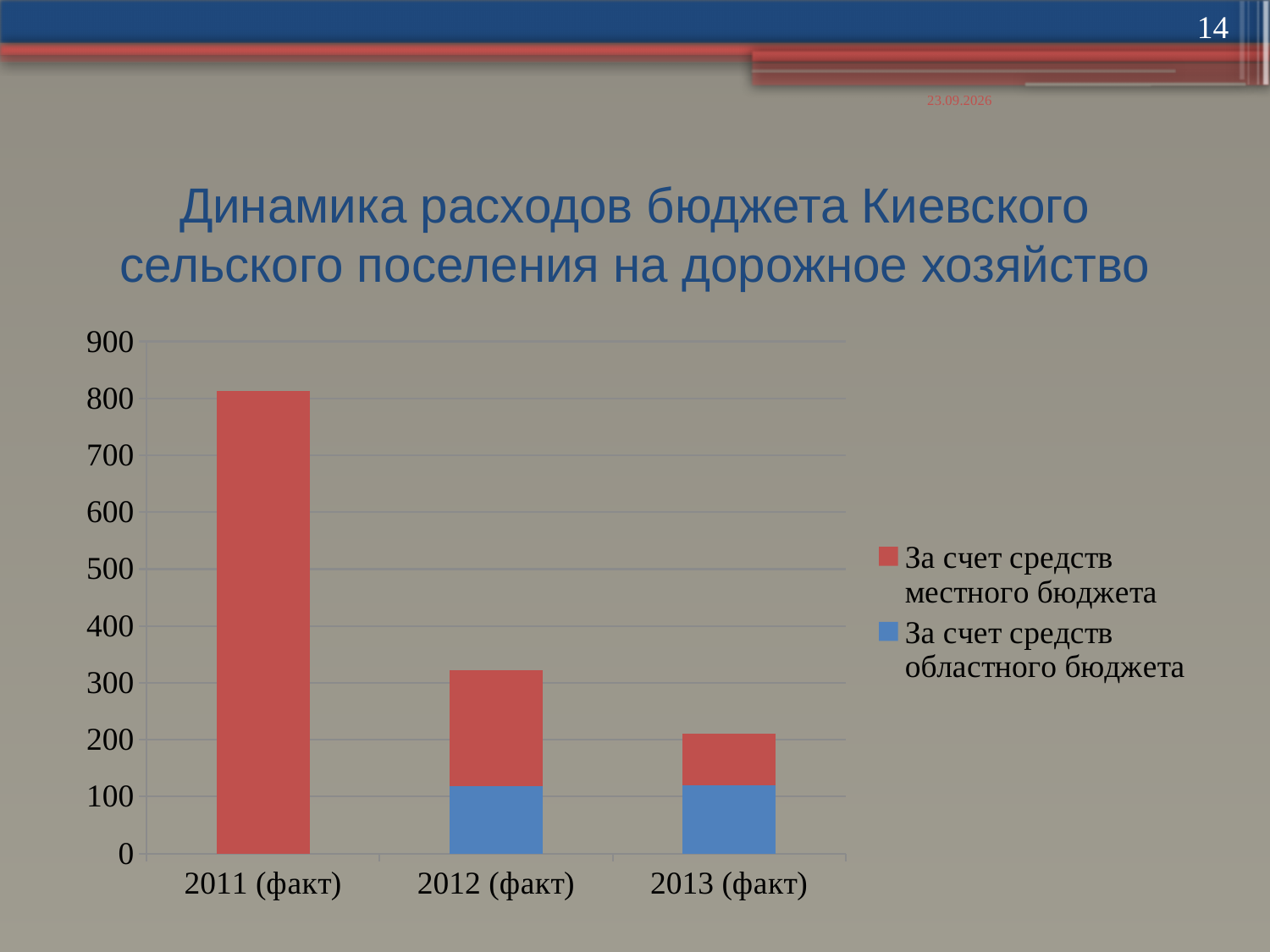
Is the total value for 2012 (факт) greater or less than 400? less What is the title of the chart on the slide? Динамика расходов бюджета Киевского сельского поселения на дорожное хозяйство Is the total value for 2011 (факт) greater or less than 700? greater Which year has the lowest total bar in the chart? 2013 (факт) How many categories are shown on the x axis of the chart? 3 How many series does the chart's legend list? 2 Which year has the highest total bar in the chart? 2011 (факт) Which is larger: the 'За счет средств местного бюджета' value for 2012 (факт) or for 2013 (факт)? 2012 (факт) Do the total bar heights rise or fall from 2011 (факт) to 2013 (факт)? Fall Is the total value for 2013 (факт) greater or less than 300? less What kind of chart is shown on the slide? Stacked bar chart Which colour represents 'За счет средств областного бюджета' in the chart? Blue